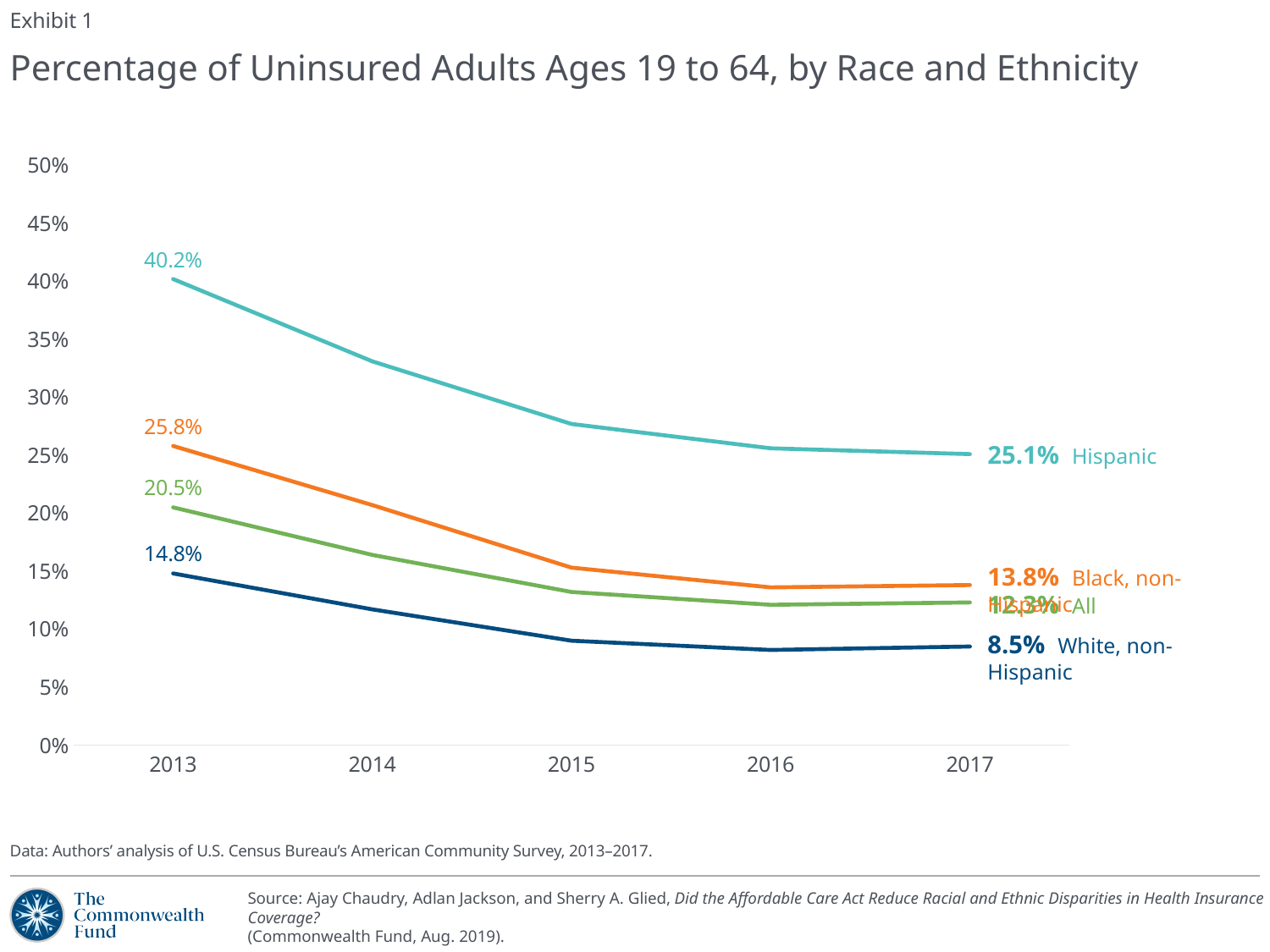
How do the uninsured rates change from 2013 to 2017 across all groups? They fall By how many percentage points did the Hispanic uninsured rate fall from 2013 to 2017? 15.1 percentage points Which group had the highest uninsured rate in 2013? Hispanic What was the percentage of uninsured Hispanic adults in 2013? 40.2% Which group had the lowest uninsured rate in 2017? White, non-Hispanic What was the percentage of uninsured White, non-Hispanic adults in 2013? 14.8% What type of chart is shown on the slide? line chart What was the percentage of uninsured Hispanic adults in 2017? 25.1% What was the percentage of uninsured White, non-Hispanic adults in 2017? 8.5% What was the percentage of uninsured Black, non-Hispanic adults in 2017? 13.8% What is the difference between the Black, non-Hispanic and White, non-Hispanic uninsured rates in 2017? 5.3 percentage points Is the Hispanic uninsured rate in 2015 greater or less than 30%? less